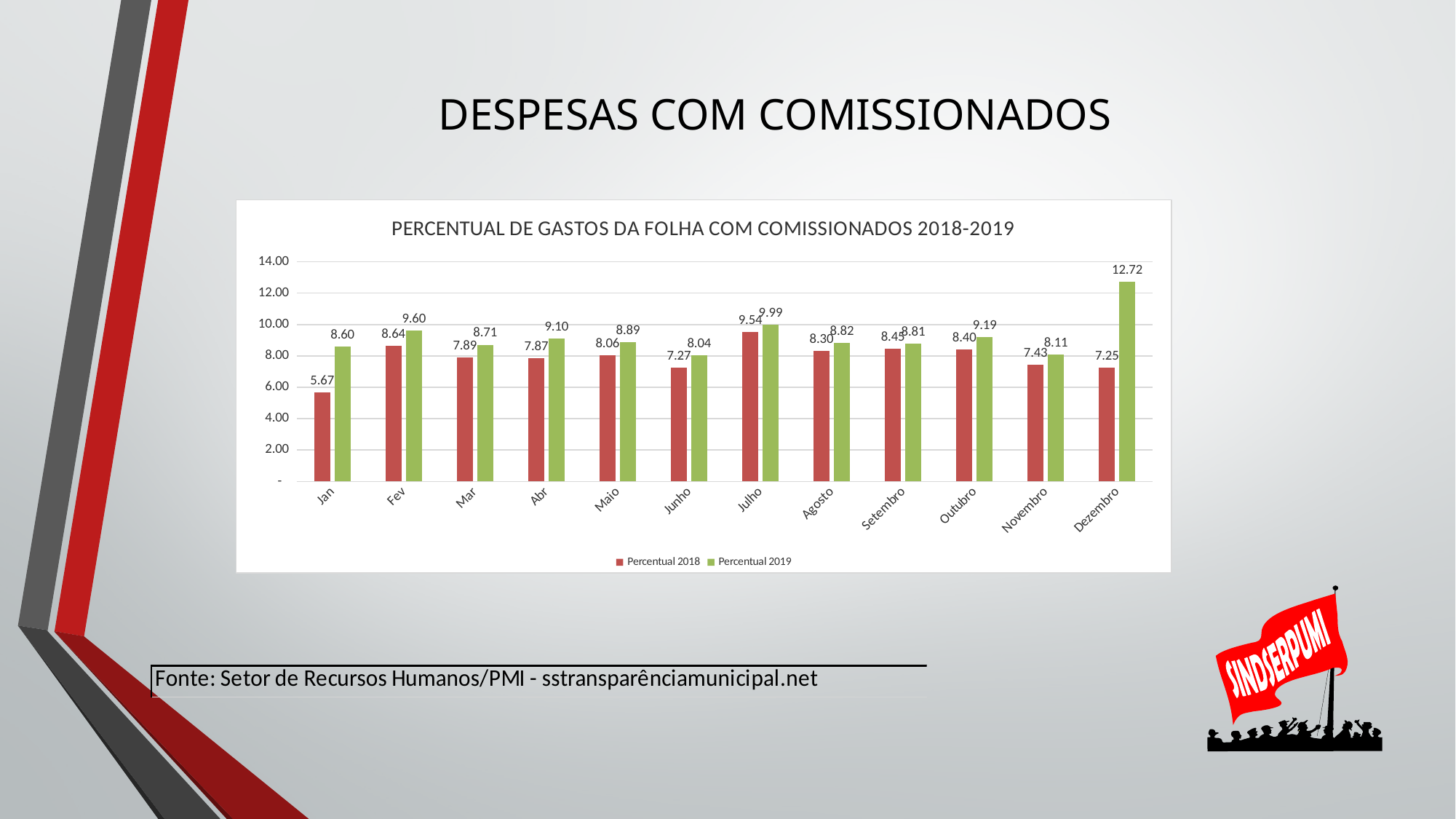
Which month has the lowest value for Percentual 2018? Jan How many months are shown on the x axis? 12 What is the value for Percentual 2019 in Dezembro? 12.72 What is the difference between Percentual 2019 and Percentual 2018 in Dezembro? 5.47 What kind of chart is shown on the slide? bar chart What is the value for Percentual 2019 in Outubro? 9.19 How many series does the legend list? 2 Which month has the highest value for Percentual 2019? Dezembro What is the difference between Percentual 2019 and Percentual 2018 in Jan? 2.93 What is the value for Percentual 2018 in Jan? 5.67 Is the value for Percentual 2019 in Dezembro greater or less than 12.00? greater Which is larger for Percentual 2018: Fev or Julho? Julho